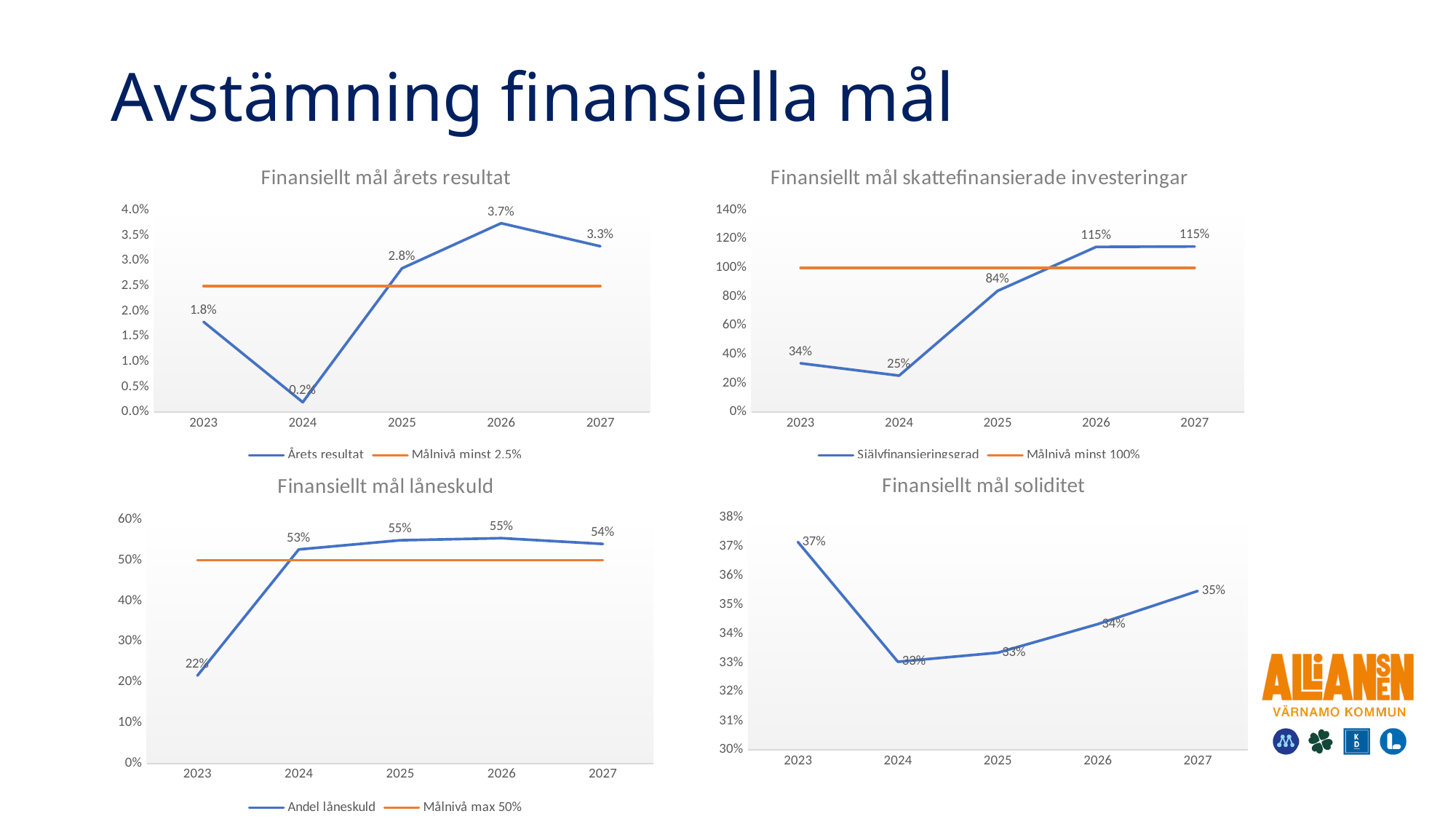
In the chart 'Finansiellt mål låneskuld', what is the name of the orange series in the legend? Målnivå max 50% In the chart 'Finansiellt mål årets resultat', how many series does the legend list? 2 In the chart 'Finansiellt mål soliditet', what is the value for 2027? 35% In the chart 'Finansiellt mål skattefinansierade investeringar', is the Självfinansieringsgrad value for 2024 greater or less than 40%? less In the chart 'Finansiellt mål låneskuld', what is the value of Andel låneskuld for 2023? 22% In the chart 'Finansiellt mål årets resultat', what is the value of Årets resultat for 2026? 3.7% In the chart 'Finansiellt mål soliditet', which year has the highest value? 2023 In the chart 'Finansiellt mål låneskuld', how many years are plotted on the x axis? 5 In the chart 'Finansiellt mål skattefinansierade investeringar', what is the difference between the 2026 and 2024 values of Självfinansieringsgrad? 90% What kind of chart is 'Finansiellt mål soliditet'? line chart In the chart 'Finansiellt mål skattefinansierade investeringar', what is the value of Självfinansieringsgrad for 2025? 84% In the chart 'Finansiellt mål årets resultat', which year has the lowest Årets resultat? 2024